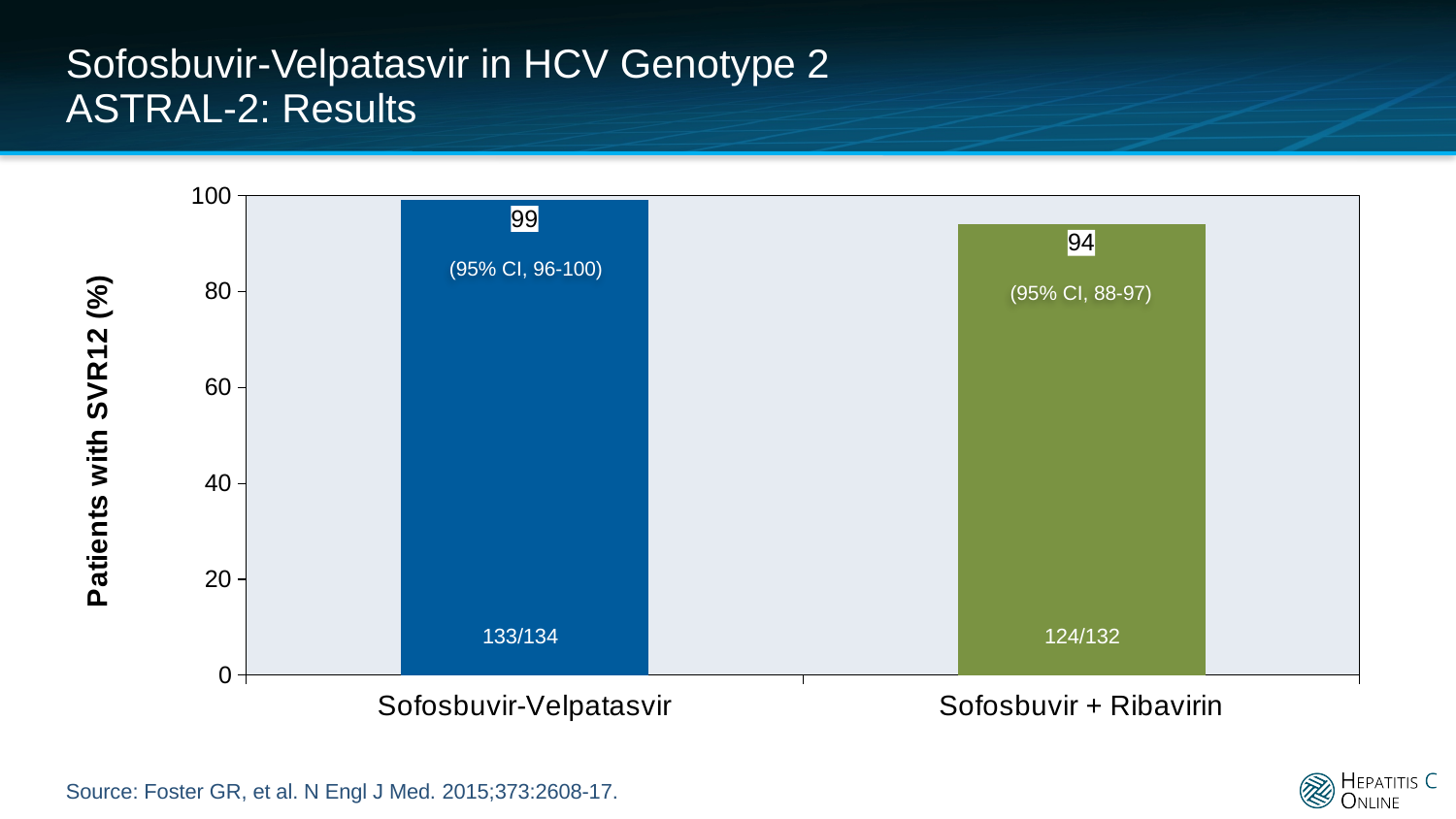
Which is larger, the SVR12 rate for Sofosbuvir-Velpatasvir or for Sofosbuvir + Ribavirin? Sofosbuvir-Velpatasvir What is the SVR12 rate for Sofosbuvir-Velpatasvir? 99 What kind of chart is shown on the slide? Bar chart What is the difference in SVR12 rate between Sofosbuvir-Velpatasvir and Sofosbuvir + Ribavirin? 5 What is the SVR12 rate for Sofosbuvir + Ribavirin? 94 Is the SVR12 rate for Sofosbuvir + Ribavirin greater or less than 80? greater Which treatment arm has the highest SVR12 rate? Sofosbuvir-Velpatasvir What is the label of the y axis? Patients with SVR12 (%) Which treatment arm has the lowest SVR12 rate? Sofosbuvir + Ribavirin How many treatment arms are shown in the chart? 2 What is the 95% confidence interval shown for Sofosbuvir-Velpatasvir? 96-100 How many patients achieved SVR12 in the Sofosbuvir + Ribavirin arm, as shown on the bar? 124/132